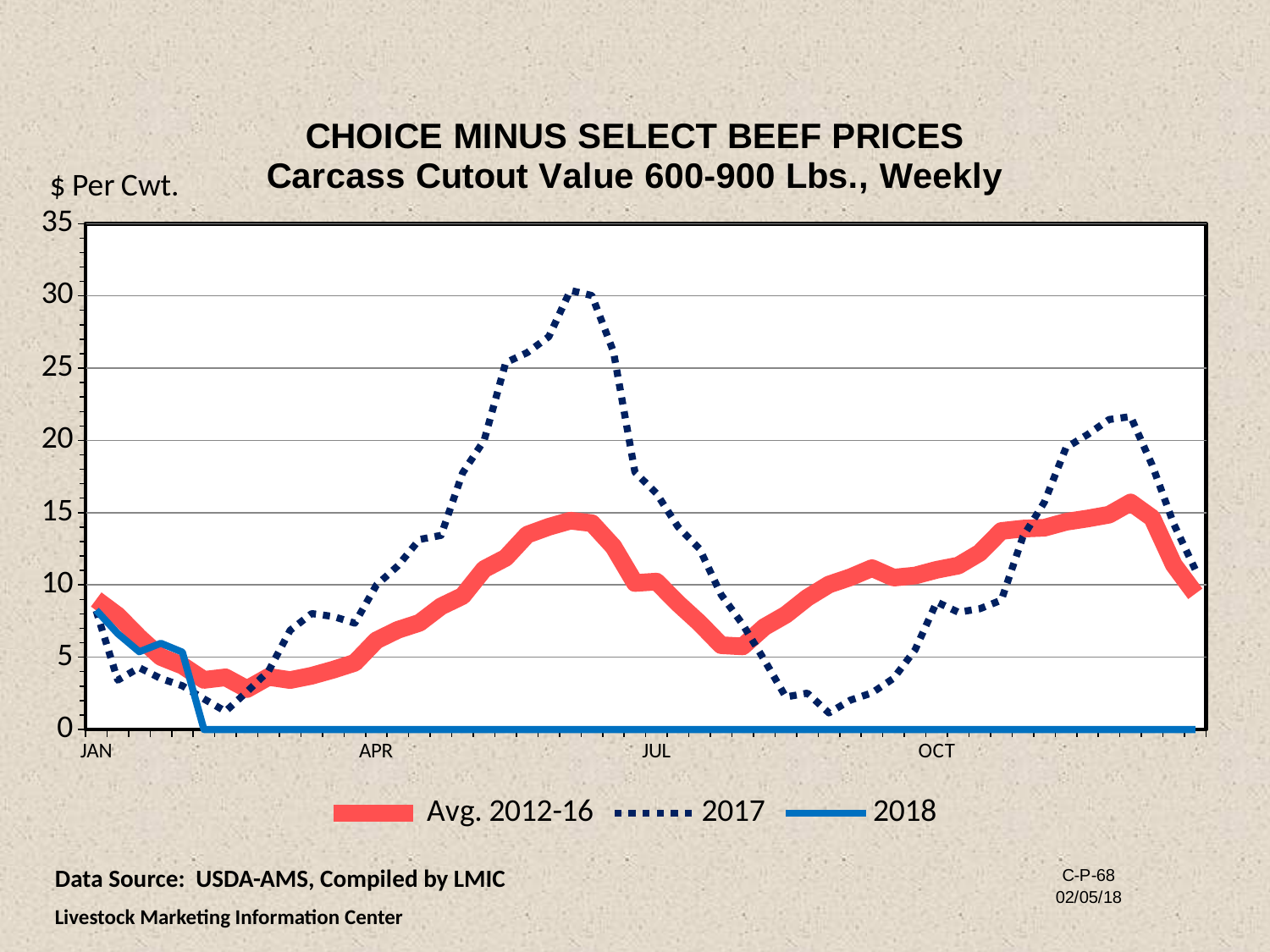
Is the lowest value of the 2017 series, reached between JUL and OCT, greater or less than 5? less Is the 2017 value at the start of JAN greater or less than 10? less How many series does the legend list? 3 Is the peak value of the 2017 series greater or less than 25? greater What kind of chart is shown on the slide? line chart Around JUL, which series is higher, 2017 or Avg. 2012-16? 2017 What are the three series named in the legend? Avg. 2012-16, 2017, 2018 Does the Avg. 2012-16 series rise or fall from APR to JUL? rise Does the 2017 series rise or fall between JUL and the point just before OCT? fall Which series reaches the highest value on the chart, 2017 or Avg. 2012-16? 2017 What unit is shown on the y axis label? $ Per Cwt.